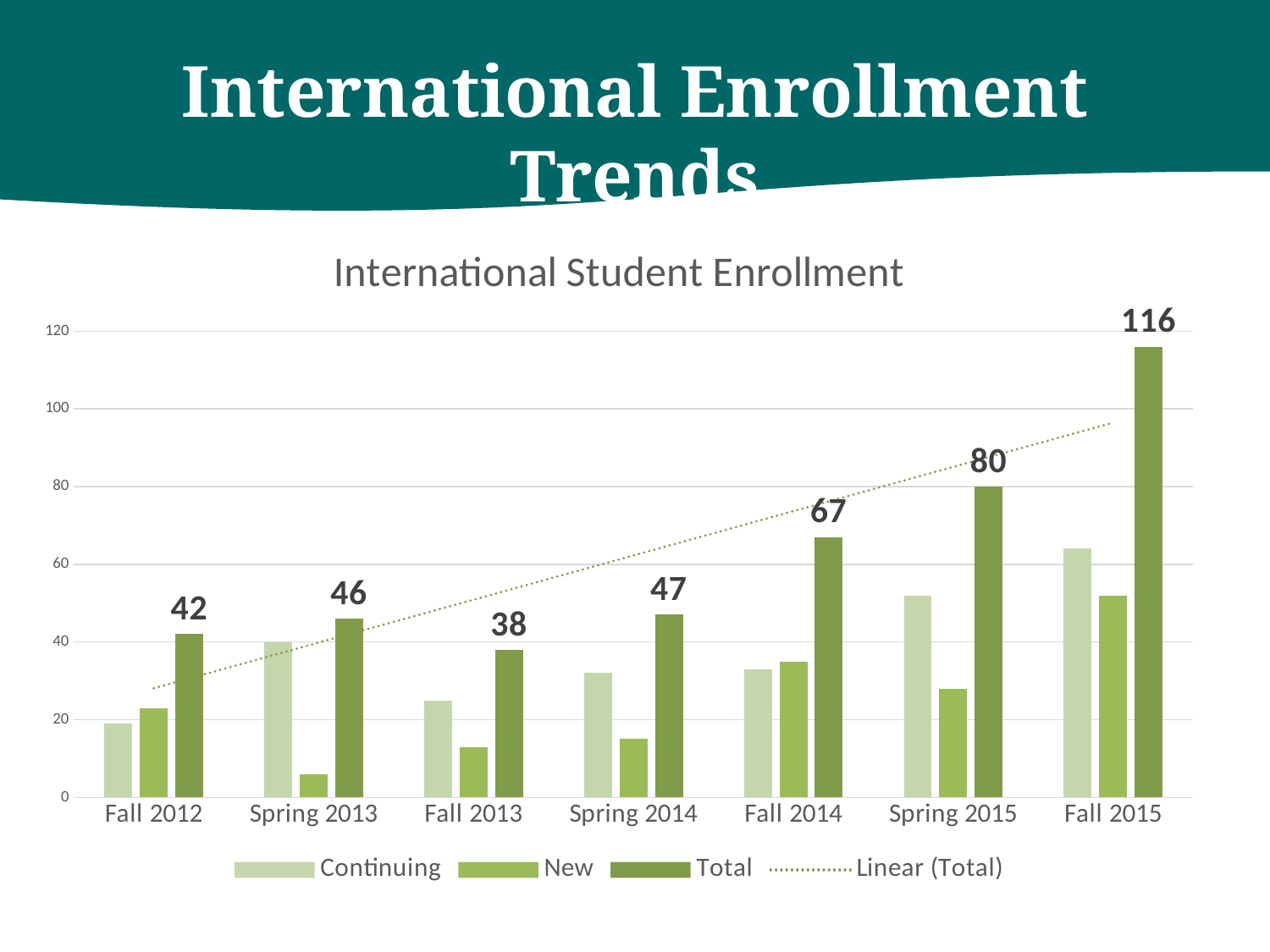
Does the Linear (Total) trendline rise or fall from Fall 2012 to Fall 2015? rise What is the Total value for Fall 2013? 38 Which term has the lowest Total value? Fall 2013 What is the Total value for Fall 2015? 116 Is the New value for Spring 2013 greater or less than 20? less What is the difference between the Total values for Fall 2015 and Fall 2014? 49 Which term has the highest Total value? Fall 2015 How many terms are shown on the x axis? 7 Is the Continuing value for Fall 2015 greater or less than 60? greater What kind of chart is shown? bar chart Which is larger, the Total value for Fall 2014 or for Spring 2015? Spring 2015 How many entries does the legend list? 4